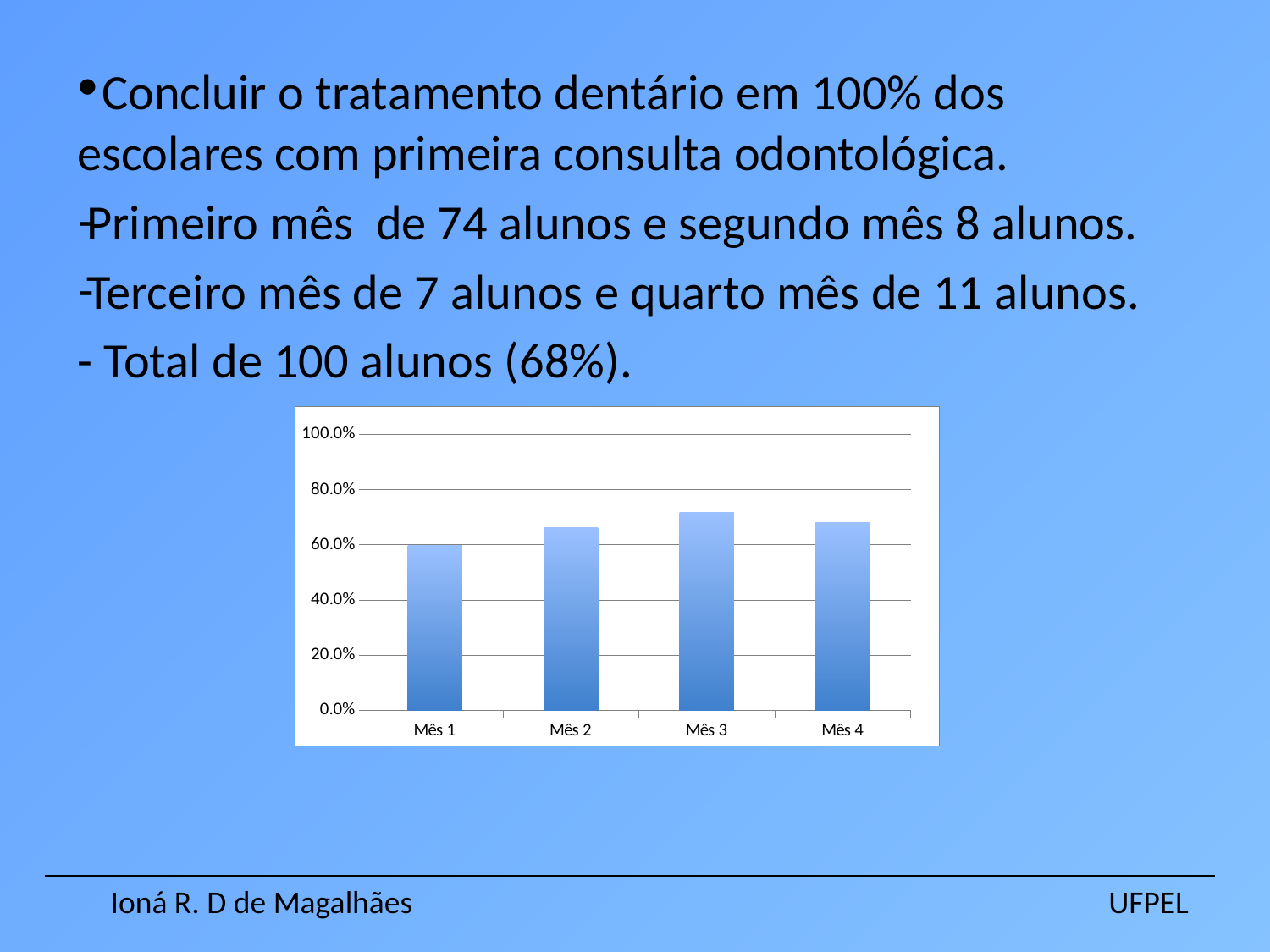
Which is larger, the value for Mês 1 or the value for Mês 4? Mês 4 What is the highest value shown on the chart's vertical axis? 100.0% How many categories (months) are plotted on the chart? 4 Is the value for Mês 4 greater or less than 60.0%? greater Which is larger, the value for Mês 2 or the value for Mês 3? Mês 3 What kind of chart is shown on the slide? bar chart Which month has the highest bar on the chart? Mês 3 Which month has the lowest bar on the chart? Mês 1 Is the value for Mês 2 greater or less than 60.0%? greater Is the value for Mês 1 greater or less than 80.0%? less Do the values rise or fall from Mês 1 to Mês 3? rise